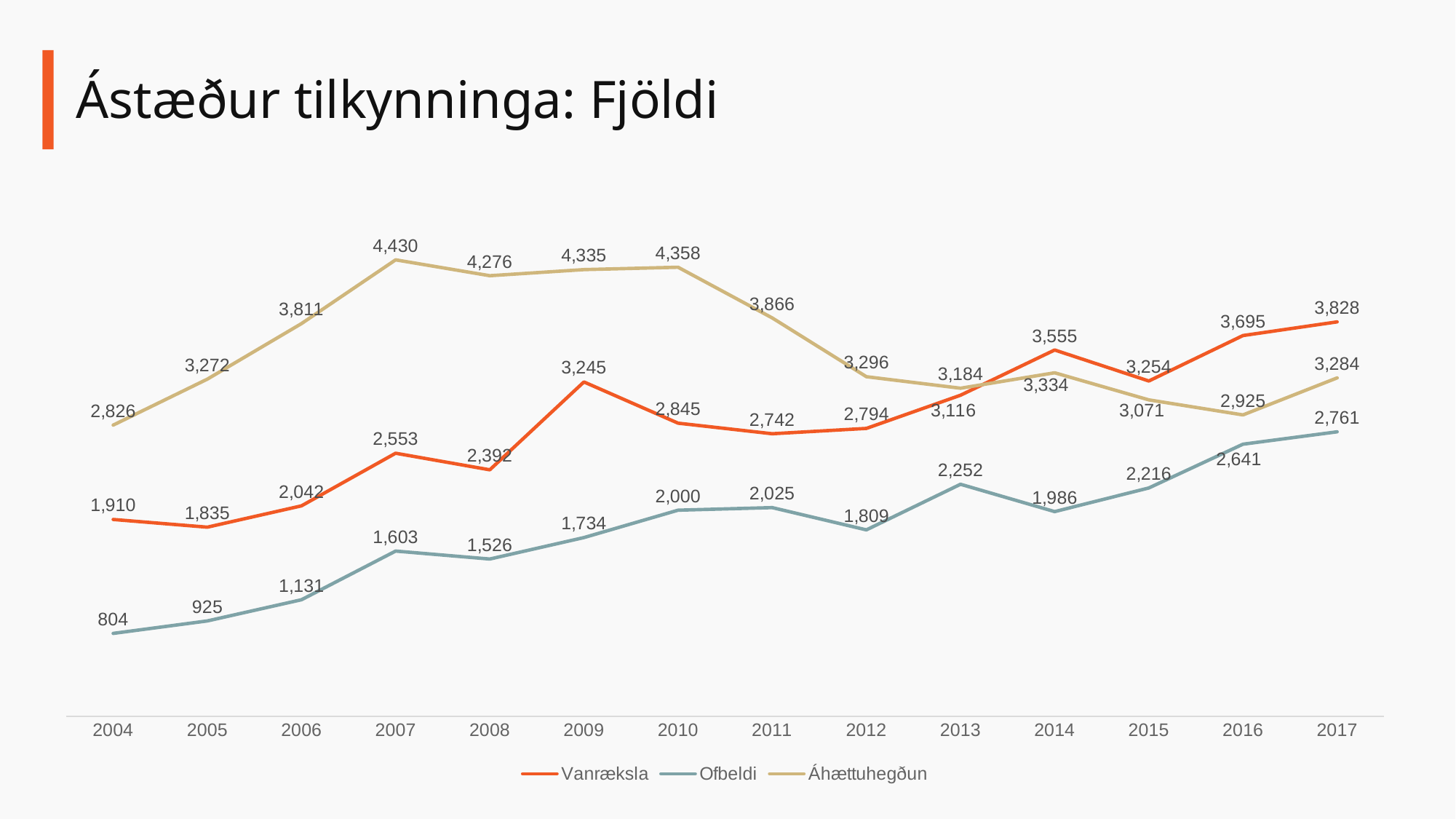
What type of chart is shown on the slide? line chart In which year is Vanræksla at its lowest? 2005 How many years are shown on the x axis? 14 What is the difference between Vanræksla and Ofbeldi in 2017? 1,067 How many series does the legend list? 3 What is the value for Áhættuhegðun in 2017? 3,284 What is the value for Vanræksla in 2009? 3,245 Which series has the higher value in 2014, Vanræksla or Áhættuhegðun? Vanræksla What is the value for Ofbeldi in 2004? 804 In which year does Áhættuhegðun reach its highest value? 2007 Does Ofbeldi generally rise or fall from 2004 to 2017? rise What is the title of the slide? Ástæður tilkynninga: Fjöldi